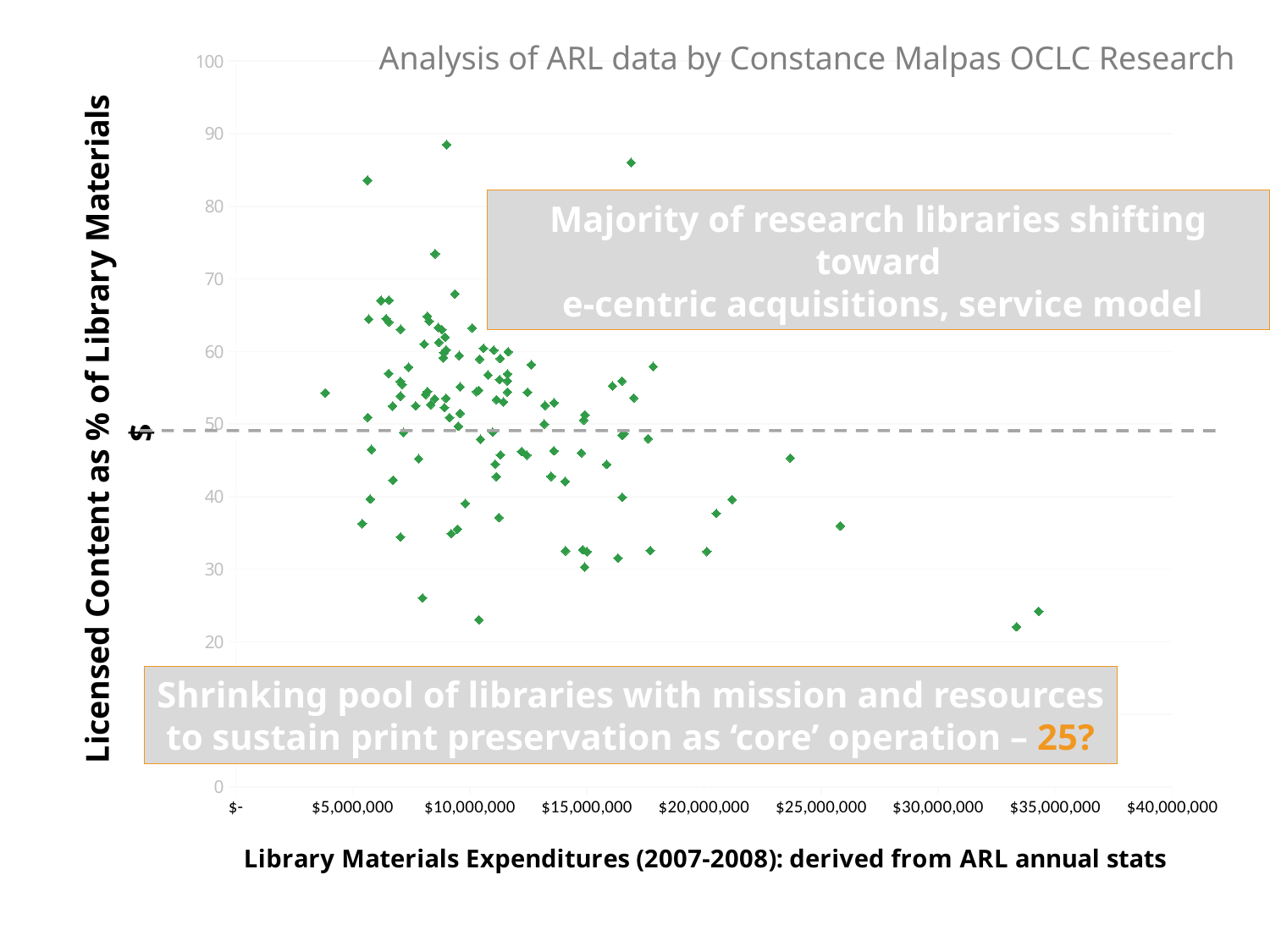
What kind of chart is shown on the slide? Scatter chart What is the title of the chart? Analysis of ARL data by Constance Malpas OCLC Research Are the two points with expenditures above $30,000,000 greater or less than 30 on the y axis? less Do the points with expenditures above $20,000,000 generally sit above or below 50 on the y axis? below Is the highest plotted point on the chart greater or less than 80 on the y axis? greater Are there any points plotted with expenditures above $35,000,000? No What is the title of the x axis? Library Materials Expenditures (2007-2008): derived from ARL annual stats Broadly, do the y values tend to rise or fall as expenditures increase along the x axis? fall